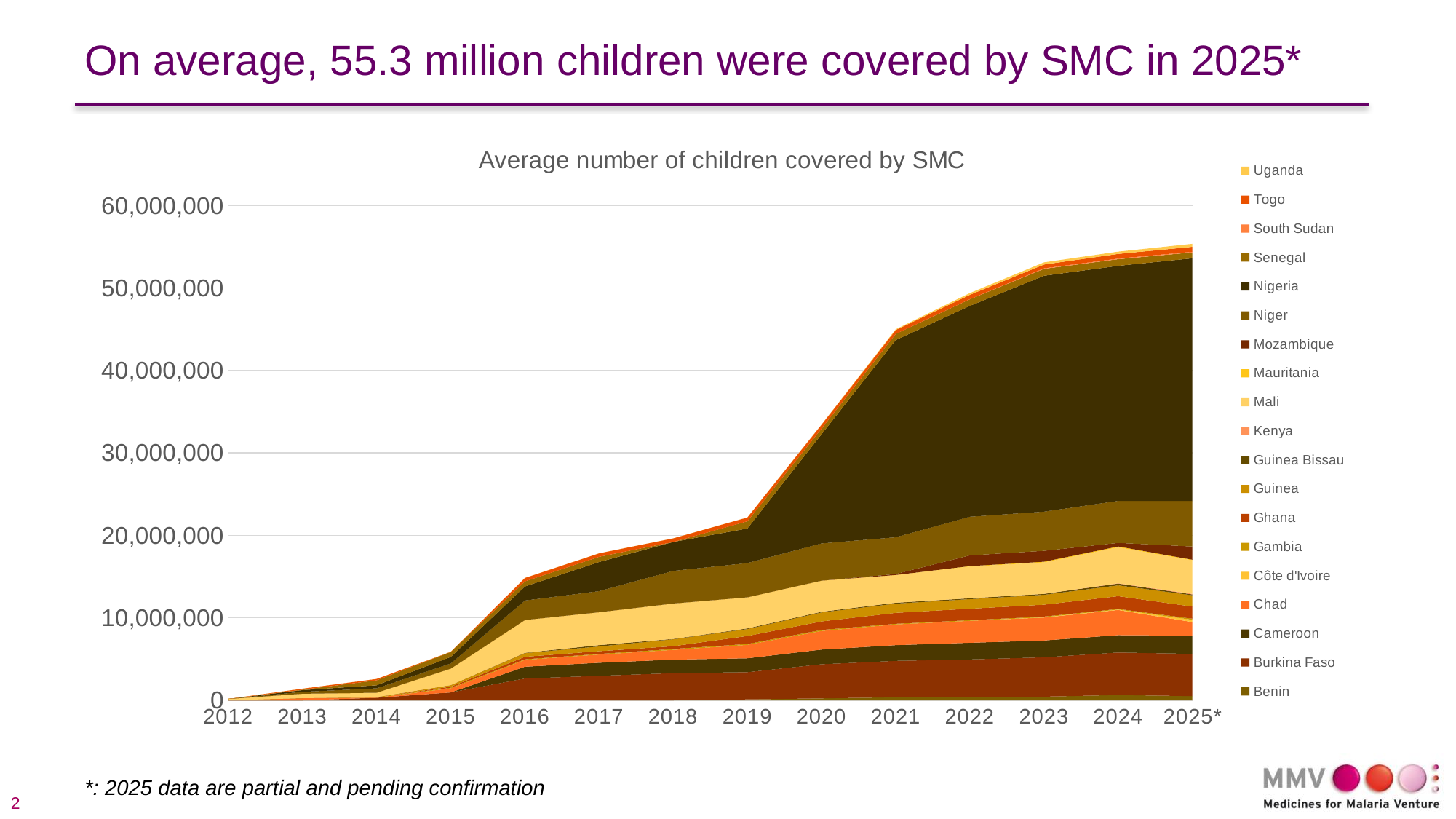
What is the last year shown on the x axis? 2025* Does the total number of children covered by SMC rise or fall from 2012 to 2025*? rise Is the total number of children covered in 2016 greater or less than 10,000,000? greater Is the total number of children covered in 2019 greater or less than 30,000,000? less What is the first year shown on the x axis? 2012 Is the total number of children covered in 2021 greater or less than 40,000,000? greater What is the title of the chart? Average number of children covered by SMC How many countries are listed in the chart legend? 19 Which country accounts for the largest area of the stack in 2025*? Nigeria How many years are shown along the x axis of the chart? 14 What kind of chart is shown on the slide? Stacked area chart